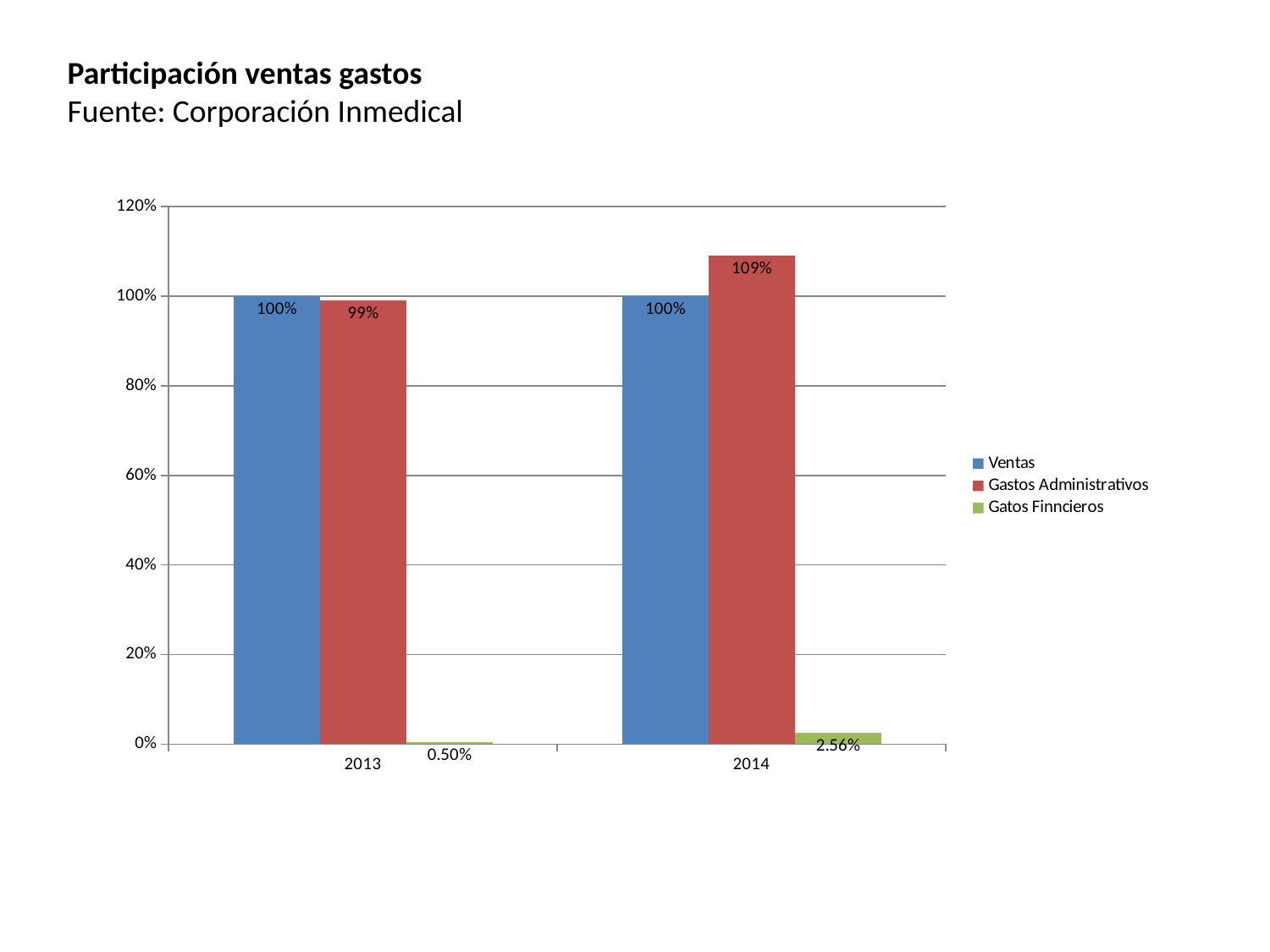
What is the value for Gastos Administrativos in 2014? 109% What kind of chart is shown on the slide? Bar chart What is the value for Gatos Finncieros in 2014? 2.56% Is the value for Gastos Administrativos in 2014 greater or less than 100%? greater Which series has the highest value in 2014? Gastos Administrativos Which is larger in 2013, Ventas or Gastos Administrativos? Ventas What is the difference between Gastos Administrativos in 2014 and in 2013? 10% What is the value for Gastos Administrativos in 2013? 99% What is the value for Gatos Finncieros in 2013? 0.50% Which series has the lowest value in 2013? Gatos Finncieros How many series does the legend list? 3 How many years are shown on the x axis? 2